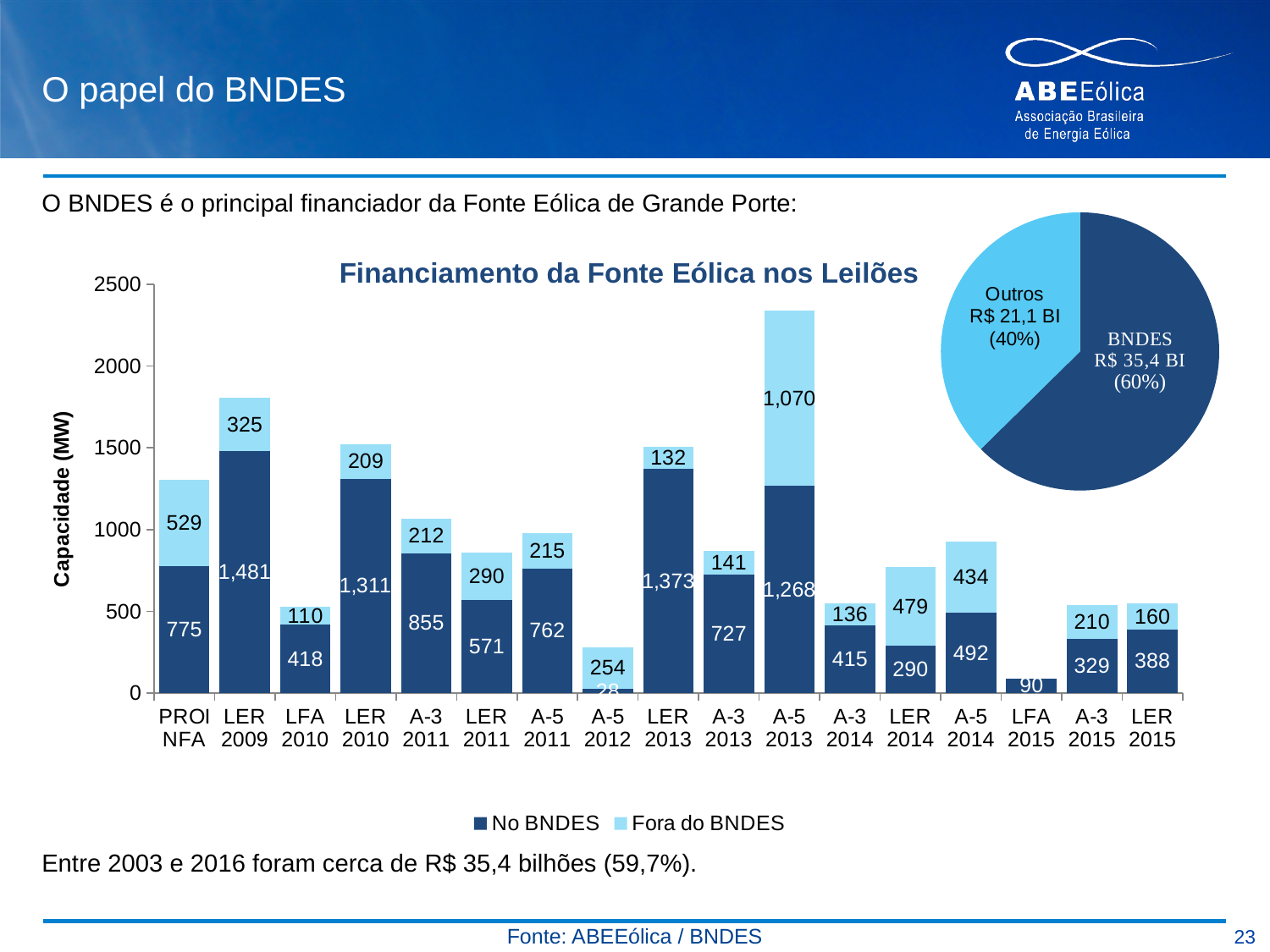
In the bar chart 'Financiamento da Fonte Eólica nos Leilões', what is the difference between the 'No BNDES' and 'Fora do BNDES' values for PROINFA? 246 In the bar chart 'Financiamento da Fonte Eólica nos Leilões', for LER 2014, which is larger: 'No BNDES' or 'Fora do BNDES'? Fora do BNDES In the bar chart 'Financiamento da Fonte Eólica nos Leilões', what is the 'Fora do BNDES' value for A-5 2013? 1,070 In the bar chart 'Financiamento da Fonte Eólica nos Leilões', what is the total capacity of the A-5 2013 bar? 2,338 In the bar chart 'Financiamento da Fonte Eólica nos Leilões', which category has the lowest 'No BNDES' value? A-5 2012 How many series does the legend of the bar chart 'Financiamento da Fonte Eólica nos Leilões' list? 2 How many categories are shown on the x axis of the bar chart 'Financiamento da Fonte Eólica nos Leilões'? 17 In the bar chart 'Financiamento da Fonte Eólica nos Leilões', which category has the highest 'No BNDES' value? LER 2009 In the bar chart 'Financiamento da Fonte Eólica nos Leilões', is the total for LER 2009 greater or less than 1500? greater In the pie chart on the right, what share does BNDES have? 60% What kind of chart is 'Financiamento da Fonte Eólica nos Leilões'? Stacked bar chart In the bar chart 'Financiamento da Fonte Eólica nos Leilões', what is the 'No BNDES' value for LER 2009? 1,481